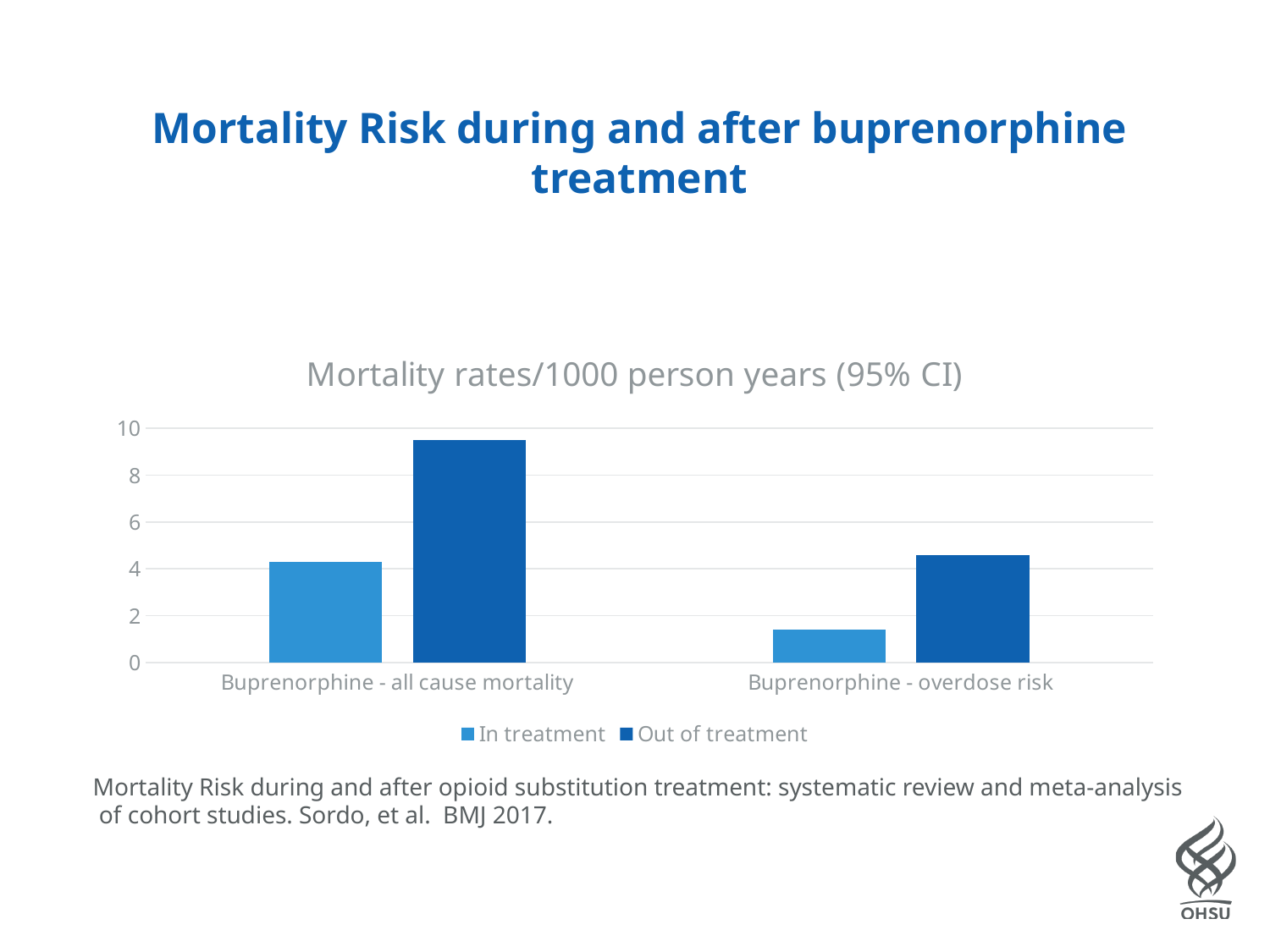
Which series is shown in the darker blue colour? Out of treatment How many categories are shown on the x axis? 2 How many series does the legend list? 2 Is the Out of treatment value for Buprenorphine - all cause mortality greater or less than 8? greater What kind of chart is shown on the slide? bar chart Which bar is the lowest in the chart? In treatment, Buprenorphine - overdose risk Which bar is the highest in the chart? Out of treatment, Buprenorphine - all cause mortality What is the title of the chart? Mortality rates/1000 person years (95% CI) Is the In treatment value for Buprenorphine - overdose risk greater or less than 2? less Is the In treatment value for Buprenorphine - all cause mortality greater or less than 6? less For Buprenorphine - overdose risk, which is larger: In treatment or Out of treatment? Out of treatment